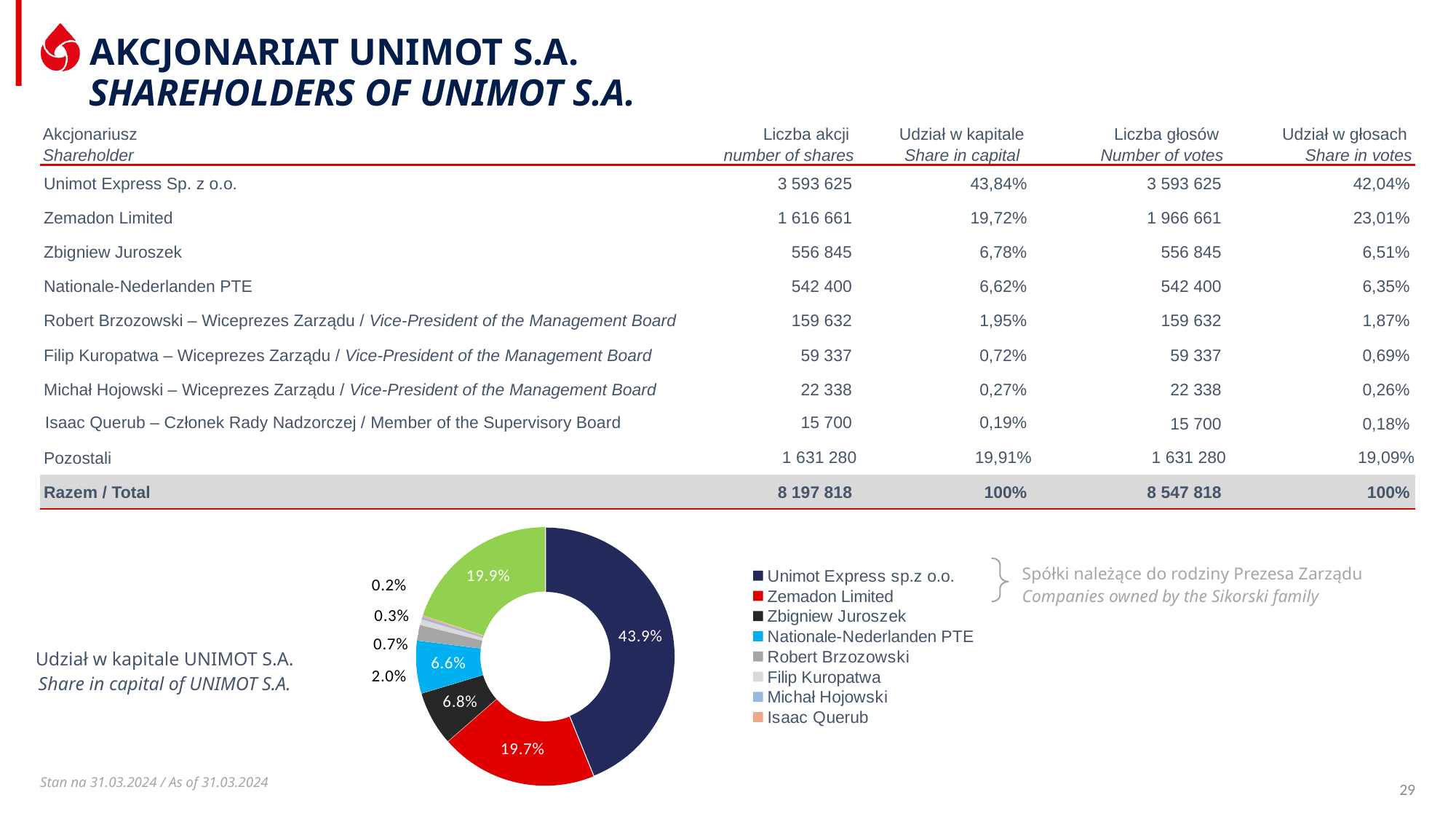
What share of capital does the pie chart show for Zemadon Limited? 19.7% How many entries does the legend of the pie chart list? 8 What share of capital does the pie chart show for Zbigniew Juroszek? 6.8% What share of capital does the pie chart show for Unimot Express sp.z o.o.? 43.9% What share of capital does the pie chart show for Nationale-Nederlanden PTE? 6.6% Which slice is larger in the pie chart: Zbigniew Juroszek or Nationale-Nederlanden PTE? Zbigniew Juroszek Which shareholder has the smallest slice in the pie chart? Isaac Querub What share of capital does the pie chart show for Robert Brzozowski? 2.0% Which shareholder has the largest slice in the pie chart? Unimot Express sp.z o.o. What colour is the Zemadon Limited slice in the pie chart? Red What kind of chart is shown on the slide? Pie (donut) chart What is the difference in percentage points between the Unimot Express sp.z o.o. slice and the Zemadon Limited slice? 24.2 percentage points